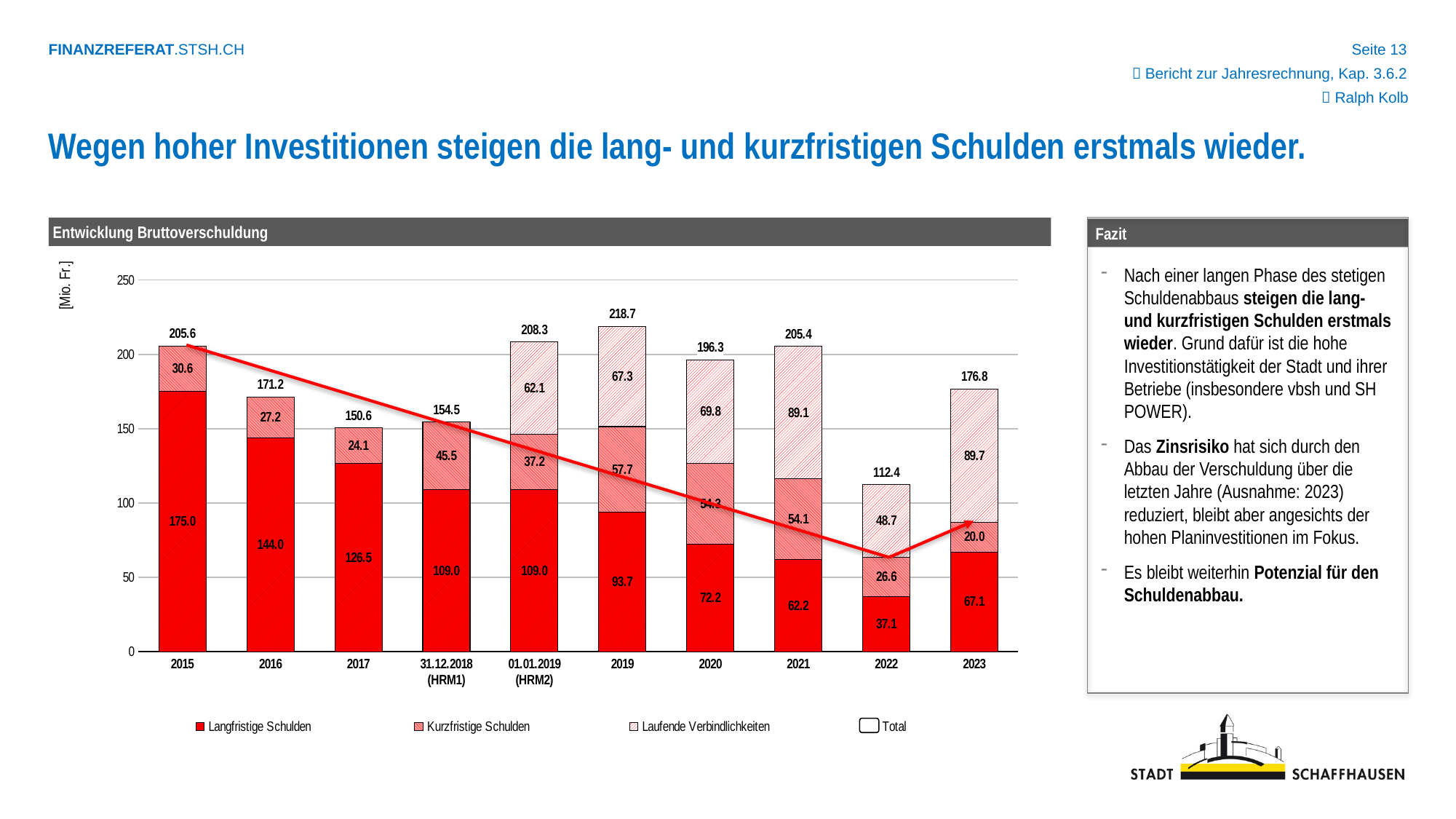
What is the value of Laufende Verbindlichkeiten in 2023? 89.7 What is the difference between the total for 2023 and the total for 2022? 64.4 Which year has the lowest total Bruttoverschuldung? 2022 Which is larger: Langfristige Schulden in 2021 or in 2023? 2023 Which year has the highest total Bruttoverschuldung? 2019 What is the value of Langfristige Schulden in 2015? 175.0 What type of chart is shown under 'Entwicklung Bruttoverschuldung'? stacked bar chart with a line (combination bar and line chart) What unit is shown on the y axis? [Mio. Fr.] How many entries does the legend list? 4 What is the total Bruttoverschuldung shown for 2019? 218.7 How many categories are shown on the x axis? 10 What is the value of Kurzfristige Schulden for 31.12.2018 (HRM1)? 45.5